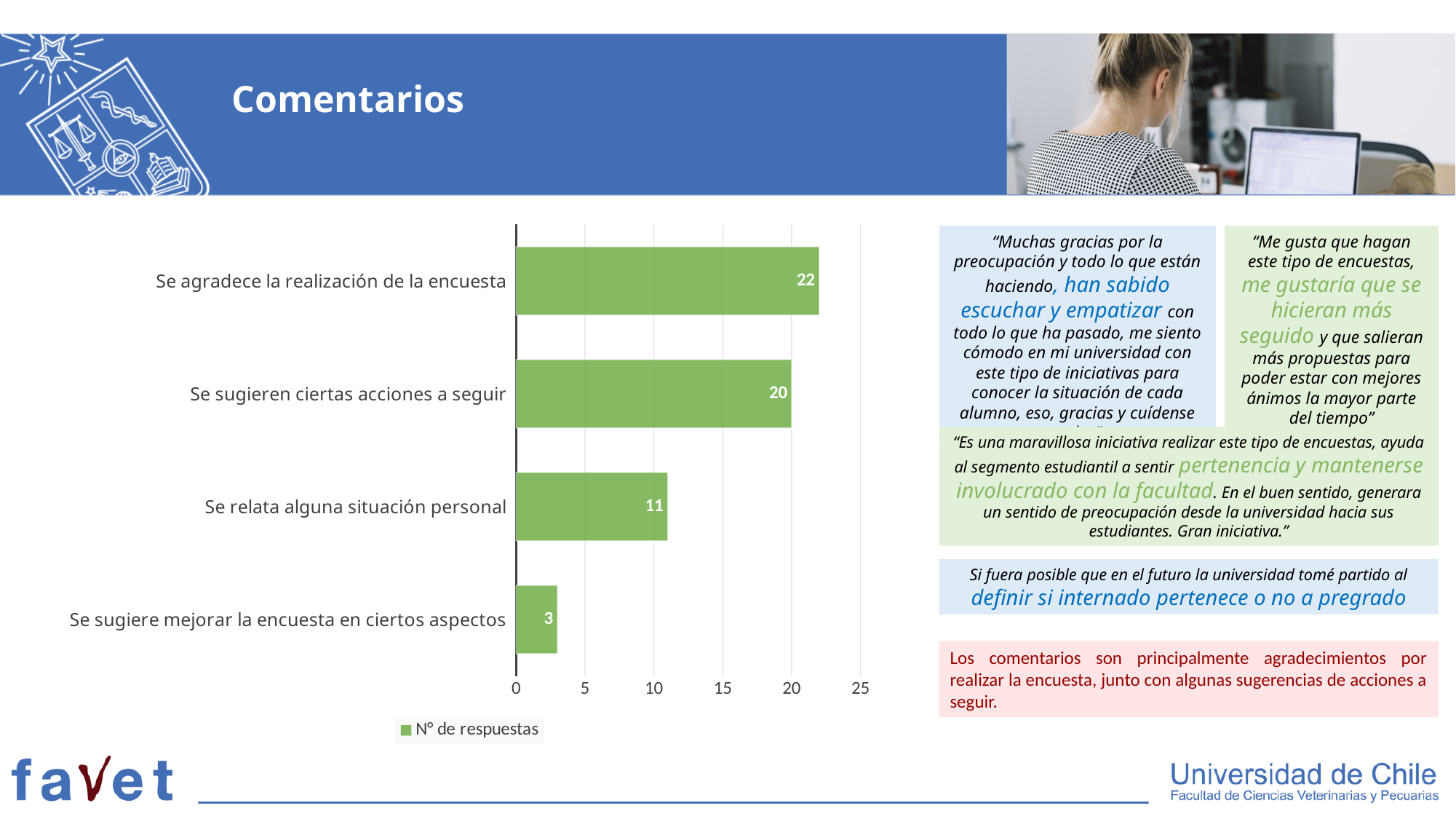
Is the value for "Se sugieren ciertas acciones a seguir" greater or less than 15? greater How many categories are shown in the chart? 4 Which has more responses: "Se sugieren ciertas acciones a seguir" or "Se relata alguna situación personal"? Se sugieren ciertas acciones a seguir What is the difference between the values for "Se agradece la realización de la encuesta" and "Se relata alguna situación personal"? 11 How many responses are recorded for "Se agradece la realización de la encuesta"? 22 What type of chart is shown on the slide? Bar chart What series name does the legend show? N° de respuestas How many responses does "Se relata alguna situación personal" have? 11 Which category has the lowest number of responses? Se sugiere mejorar la encuesta en ciertos aspectos Which category has the highest number of responses? Se agradece la realización de la encuesta What is the value for "Se sugieren ciertas acciones a seguir"? 20 What is the value for "Se sugiere mejorar la encuesta en ciertos aspectos"? 3